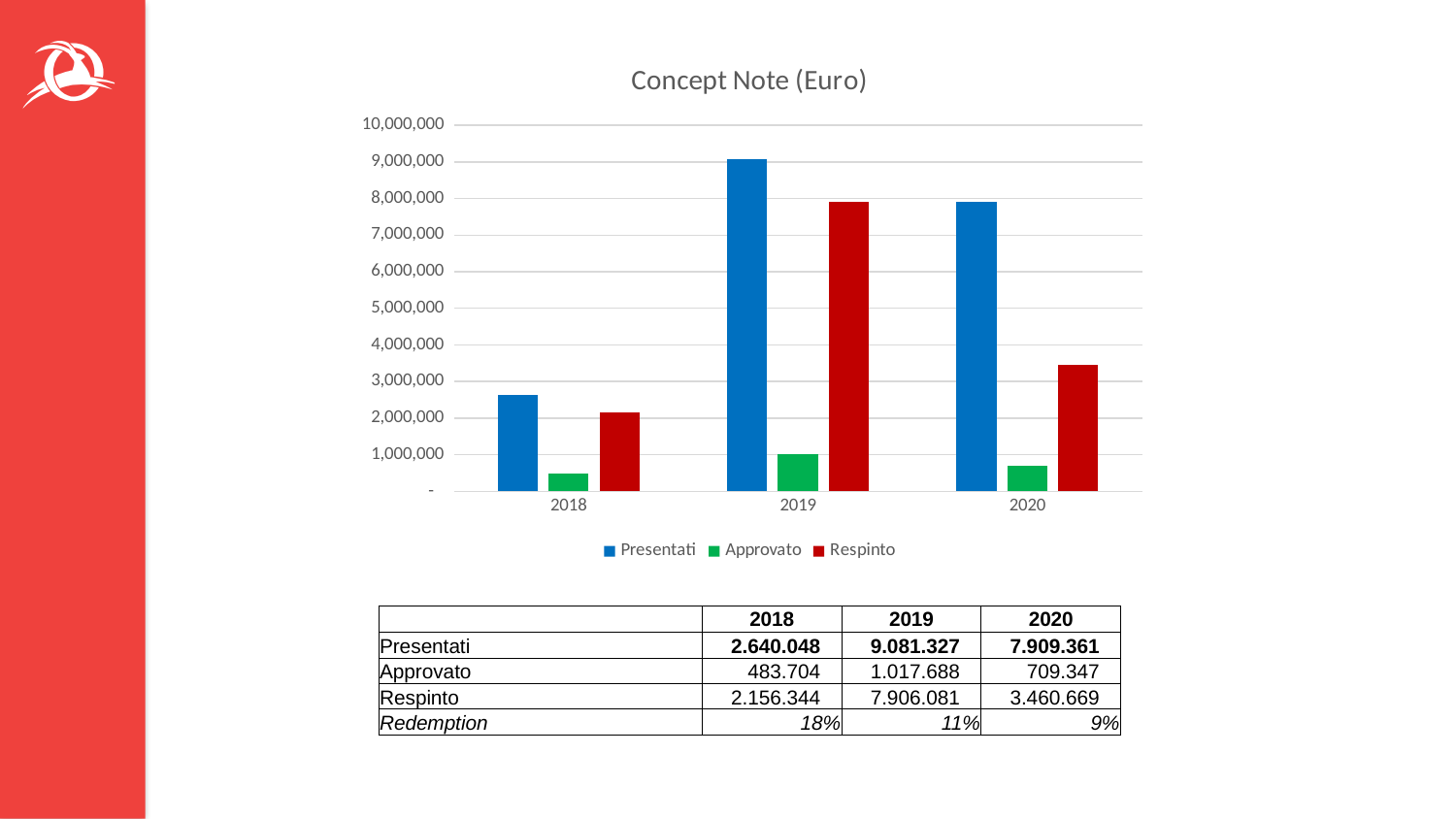
In which year is the Presentati bar highest? 2019 Which is larger in 2020, Presentati or Respinto? Presentati What kind of chart is shown on the slide? bar chart How many series does the chart legend list? 3 What is the value of Respinto for 2018? 2.156.344 In which year is the Approvato bar lowest? 2018 What is the title of the chart? Concept Note (Euro) What is the value of Presentati for 2019? 9.081.327 What is the value of Approvato for 2020? 709.347 How many years are shown on the x axis of the chart? 3 Which colour represents the Respinto series in the chart? red Is the Respinto value for 2019 greater or less than 7,000,000? greater